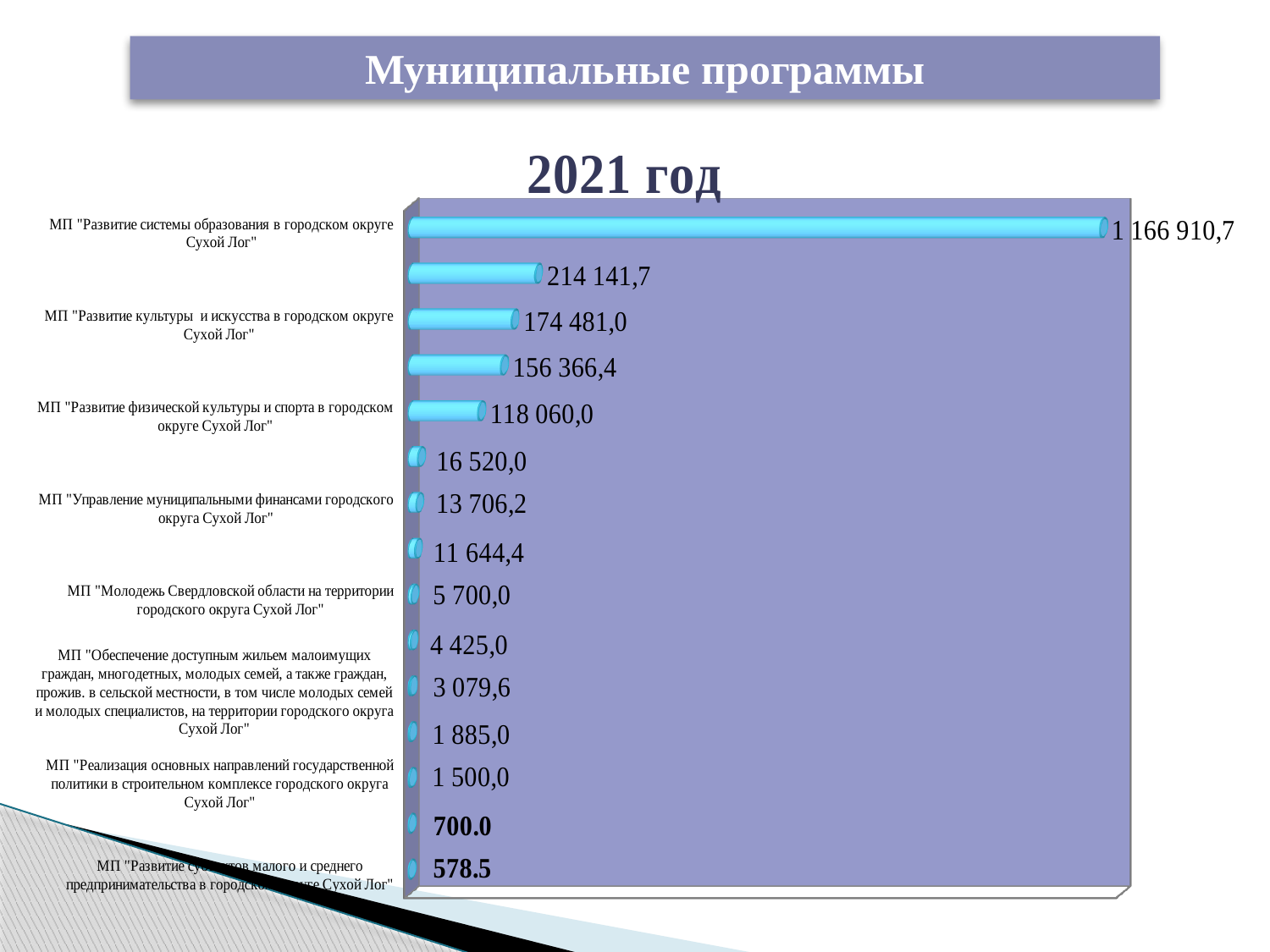
What is the difference between the values for МП "Развитие культуры и искусства" and МП "Развитие физической культуры и спорта"? 56 421,0 What is the value for МП "Развитие системы образования в городском округе Сухой Лог"? 1 166 910,7 Which is larger: the value for МП "Управление муниципальными финансами" or МП "Молодежь Свердловской области"? МП "Управление муниципальными финансами городского округа Сухой Лог" What is the title of the chart? 2021 год What is the value for МП "Управление муниципальными финансами городского округа Сухой Лог"? 13 706,2 What is the smallest value shown in the chart? 578.5 What type of chart is shown on the slide? Bar chart What is the value for МП "Молодежь Свердловской области на территории городского округа Сухой Лог"? 5 700,0 What is the value for МП "Развитие культуры и искусства в городском округе Сухой Лог"? 174 481,0 What is the value for МП "Развитие физической культуры и спорта в городском округе Сухой Лог"? 118 060,0 How many bars are plotted in the chart? 15 Which program has the highest value in the chart? МП "Развитие системы образования в городском округе Сухой Лог"